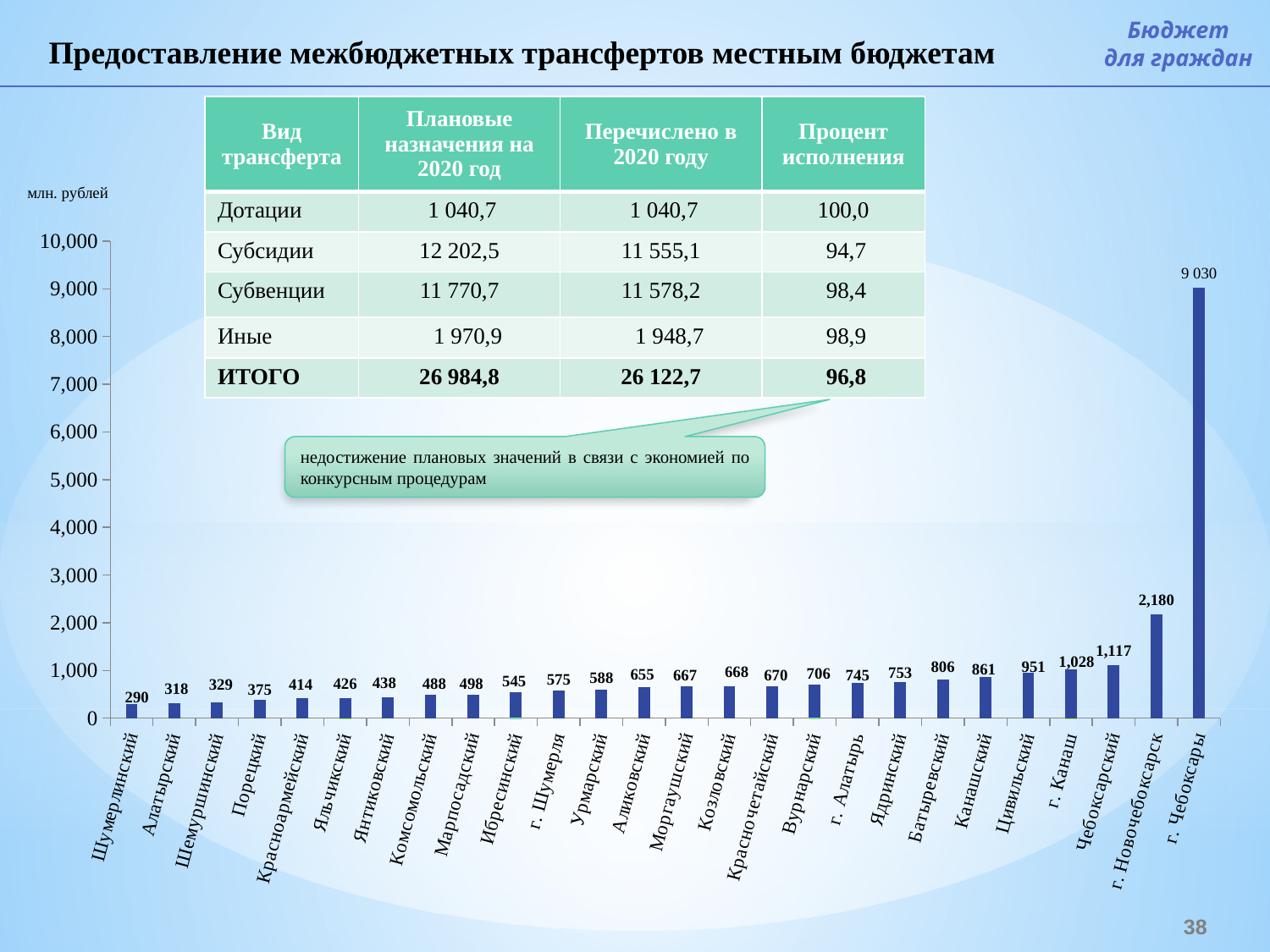
What is the value for г. Новочебоксарск? 2,180 What is the value for Канашский? 861 What is the difference between the values for г. Новочебоксарск and Чебоксарский? 1,063 What is the value for г. Чебоксары? 9 030 What kind of chart is shown on the slide? bar chart Is the value for г. Чебоксары greater or less than 8,000? greater What is the value for Шумерлинский? 290 Do the values rise or fall from left to right along the x axis? rise Which is larger, the value for Вурнарский or the value for Ядринский? Ядринский Which category has the lowest value? Шумерлинский How many categories are shown on the x axis of the bar chart? 26 Which category has the highest value? г. Чебоксары